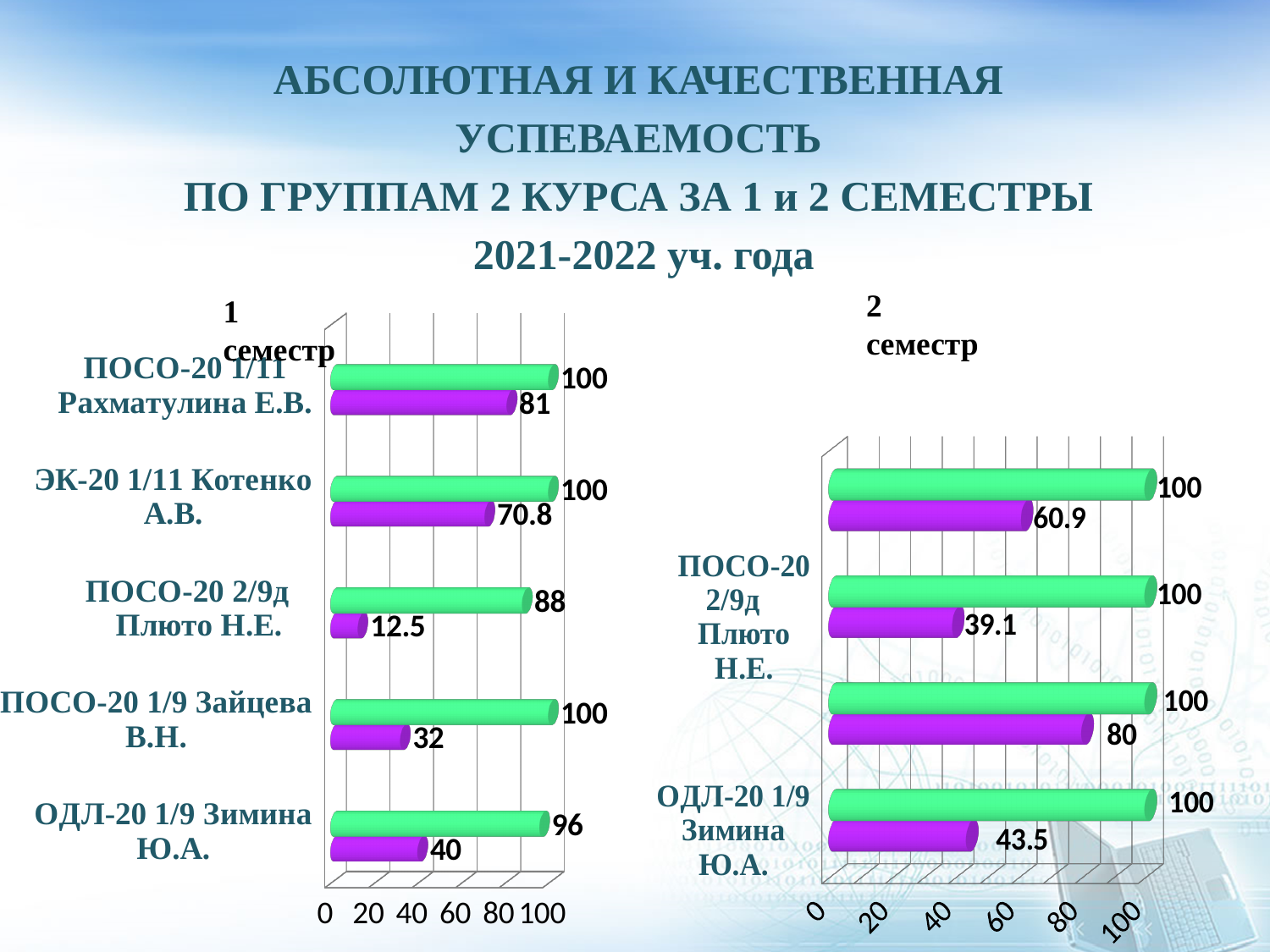
In the '1 семестр' chart, how many groups are shown? 5 In the '2 семестр' chart, what is the value of the purple bar for ПОСО-20 2/9д Плюто Н.Е.? 39.1 In the '1 семестр' chart, is the purple bar value for ОДЛ-20 1/9 Зимина Ю.А. greater or less than 60? less In the '1 семестр' chart, what is the difference between the green and purple bar values for ПОСО-20 1/9 Зайцева В.Н.? 68 In the '2 семестр' chart, what is the difference between the green and purple bar values for ПОСО-20 2/9д Плюто Н.Е.? 60.9 In the '1 семестр' chart, which group has the lowest green bar value? ПОСО-20 2/9д Плюто Н.Е. In the '1 семестр' chart, which group has the lowest purple bar value? ПОСО-20 2/9д Плюто Н.Е. In the '1 семестр' chart, what is the value of the purple bar for ЭК-20 1/11 Котенко А.В.? 70.8 In the '1 семестр' chart, what is the value of the green bar for ПОСО-20 2/9д Плюто Н.Е.? 88 In the '1 семестр' chart, which purple bar is larger: ПОСО-20 1/11 Рахматулина Е.В. or ЭК-20 1/11 Котенко А.В.? ПОСО-20 1/11 Рахматулина Е.В. In the '2 семестр' chart, what is the value of the purple bar for ОДЛ-20 1/9 Зимина Ю.А.? 43.5 What type of chart is the '2 семестр' chart? Bar chart